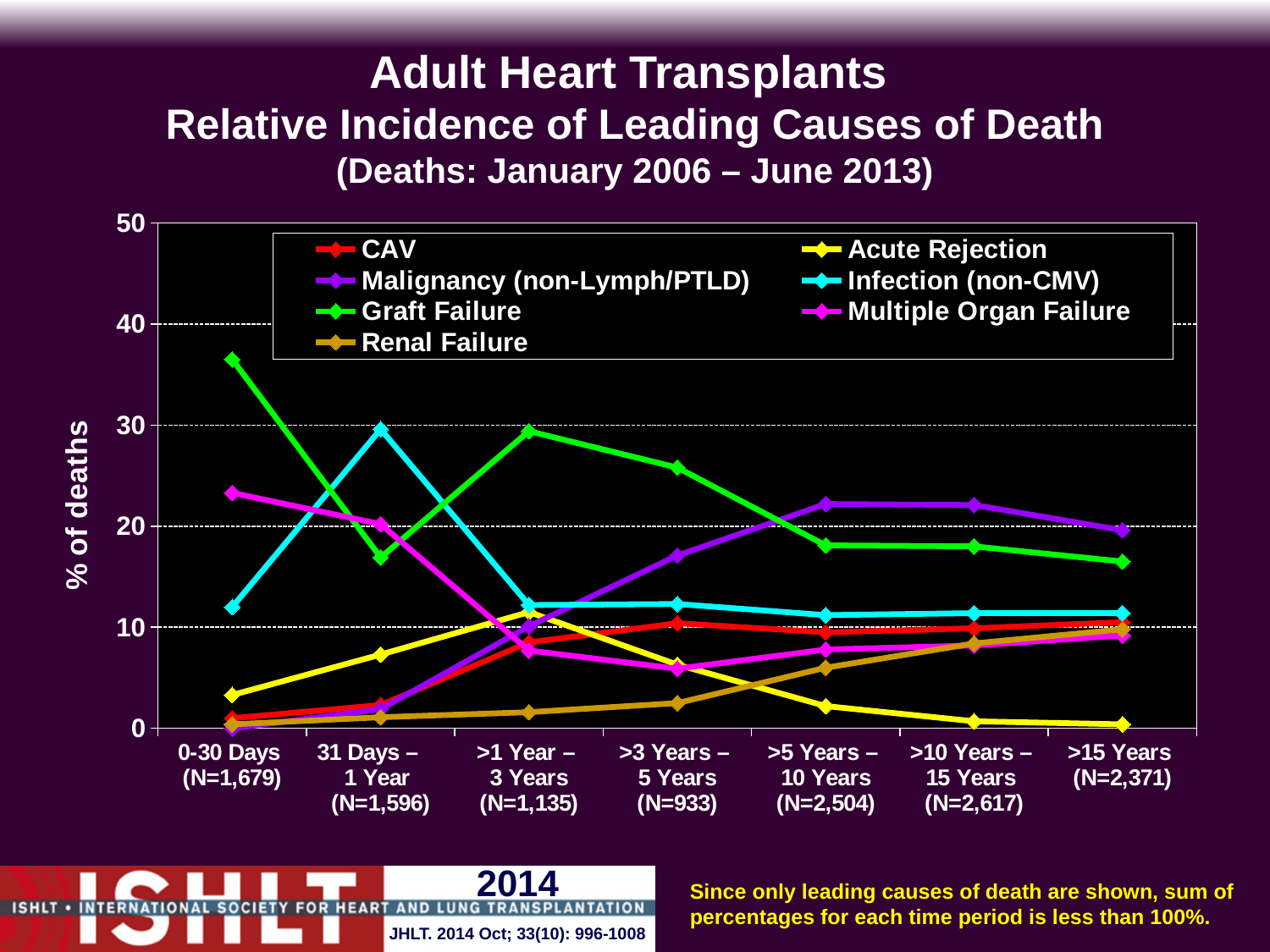
How many time periods are shown along the x axis? 7 Which cause of death has the highest percentage in the >5 Years – 10 Years period? Malignancy (non-Lymph/PTLD) In the >15 Years period, which is larger: Malignancy (non-Lymph/PTLD) or Graft Failure? Malignancy (non-Lymph/PTLD) Which cause of death has the lowest percentage in the >15 Years period? Acute Rejection Does the Malignancy (non-Lymph/PTLD) line rise or fall from 0-30 Days to >5 Years – 10 Years? Rises Is the value for Graft Failure in the 0-30 Days period greater or less than 30? greater How many causes of death does the legend list? 7 Which cause of death has the highest percentage in the 31 Days – 1 Year period? Infection (non-CMV) What kind of chart is shown on the slide? Line chart Which cause of death has the highest percentage in the 0-30 Days period? Graft Failure What is the label on the y axis? % of deaths Is the value for Multiple Organ Failure in the 0-30 Days period greater or less than 20? greater